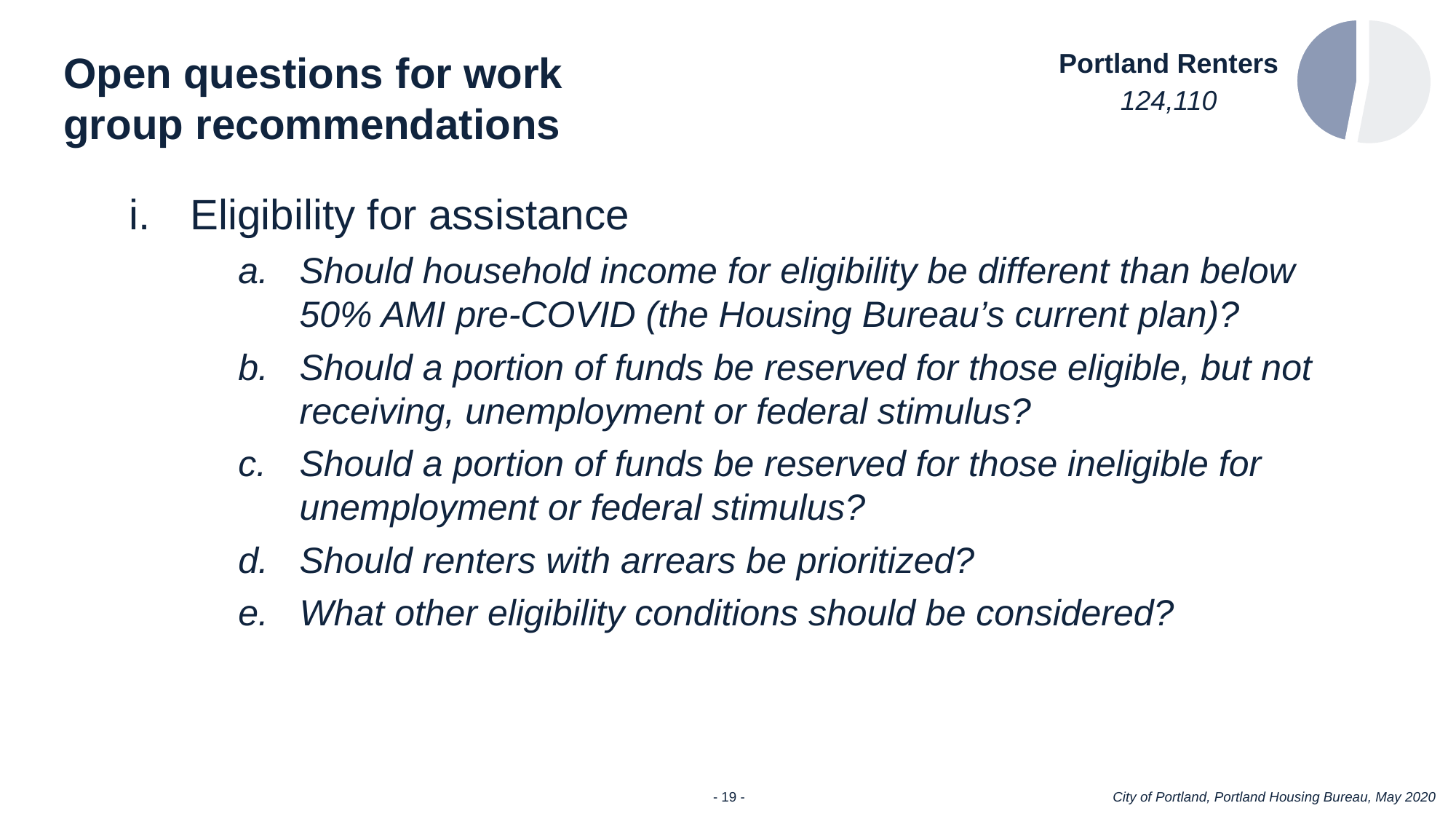
What number is printed beneath the "Portland Renters" label next to the pie chart? 124,110 What label appears next to the pie chart in the top right corner? Portland Renters What kind of chart is shown in the top right corner of the slide? pie chart How many slices does the pie chart in the top right corner have? 2